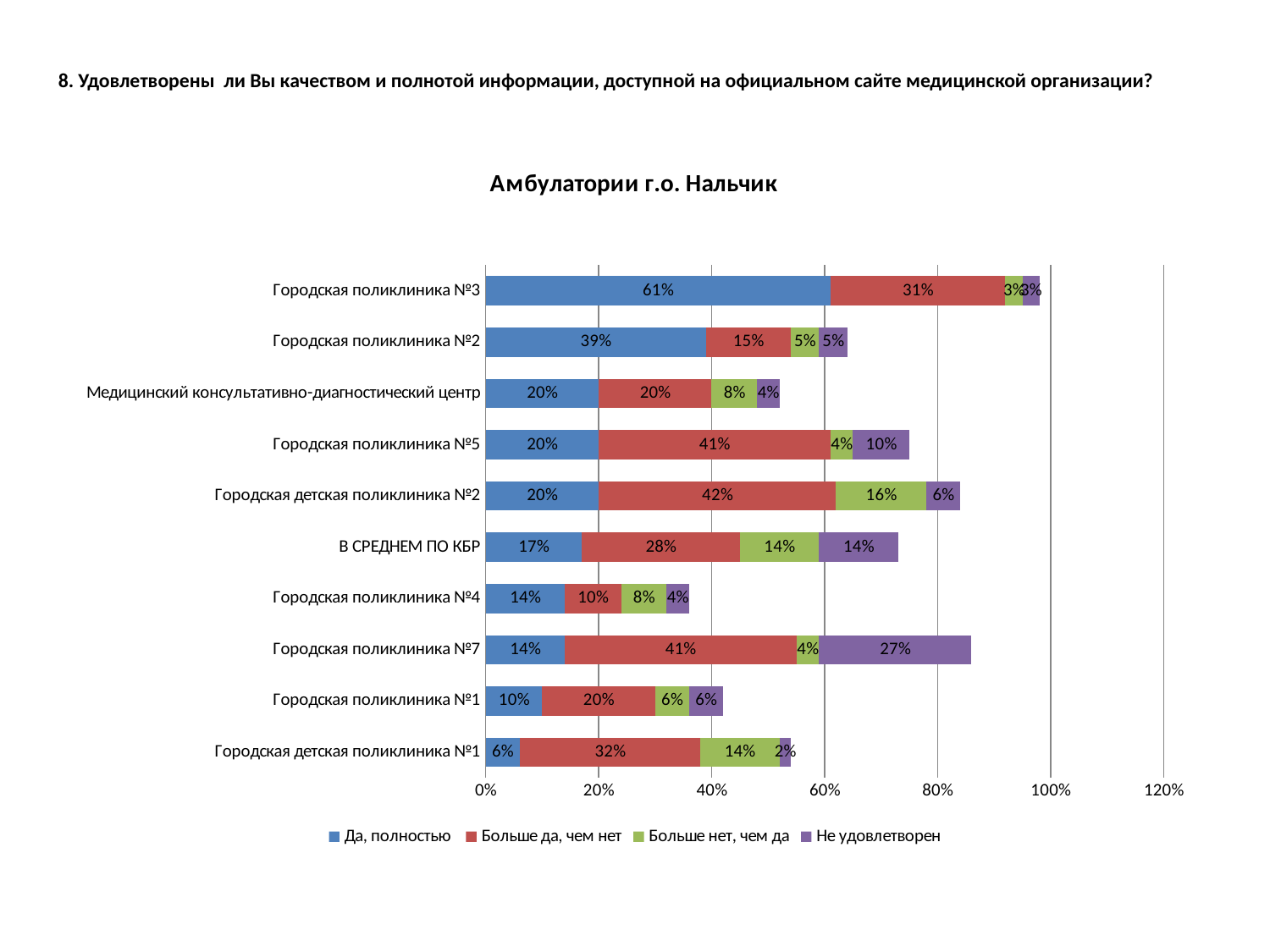
How many series does the legend list? 4 What type of chart is shown on the slide? Stacked bar chart What is the "Больше нет, чем да" value for Городская детская поликлиника №2? 16% What is the total of the stacked bar for Городская поликлиника №4? 36% What is the total of the stacked bar for Городская поликлиника №2? 64% Which is larger: the "Не удовлетворен" value for Городская поликлиника №5 or for В СРЕДНЕМ ПО КБР? В СРЕДНЕМ ПО КБР Which category has the highest "Да, полностью" value? Городская поликлиника №3 What is the difference between the "Больше да, чем нет" values for Городская детская поликлиника №2 and Городская поликлиника №4? 32% What is the "Не удовлетворен" value for Городская поликлиника №7? 27% How many categories are shown on the vertical axis? 10 What percentage of respondents at Городская поликлиника №3 answered "Да, полностью"? 61% Which category has the lowest "Да, полностью" value? Городская детская поликлиника №1